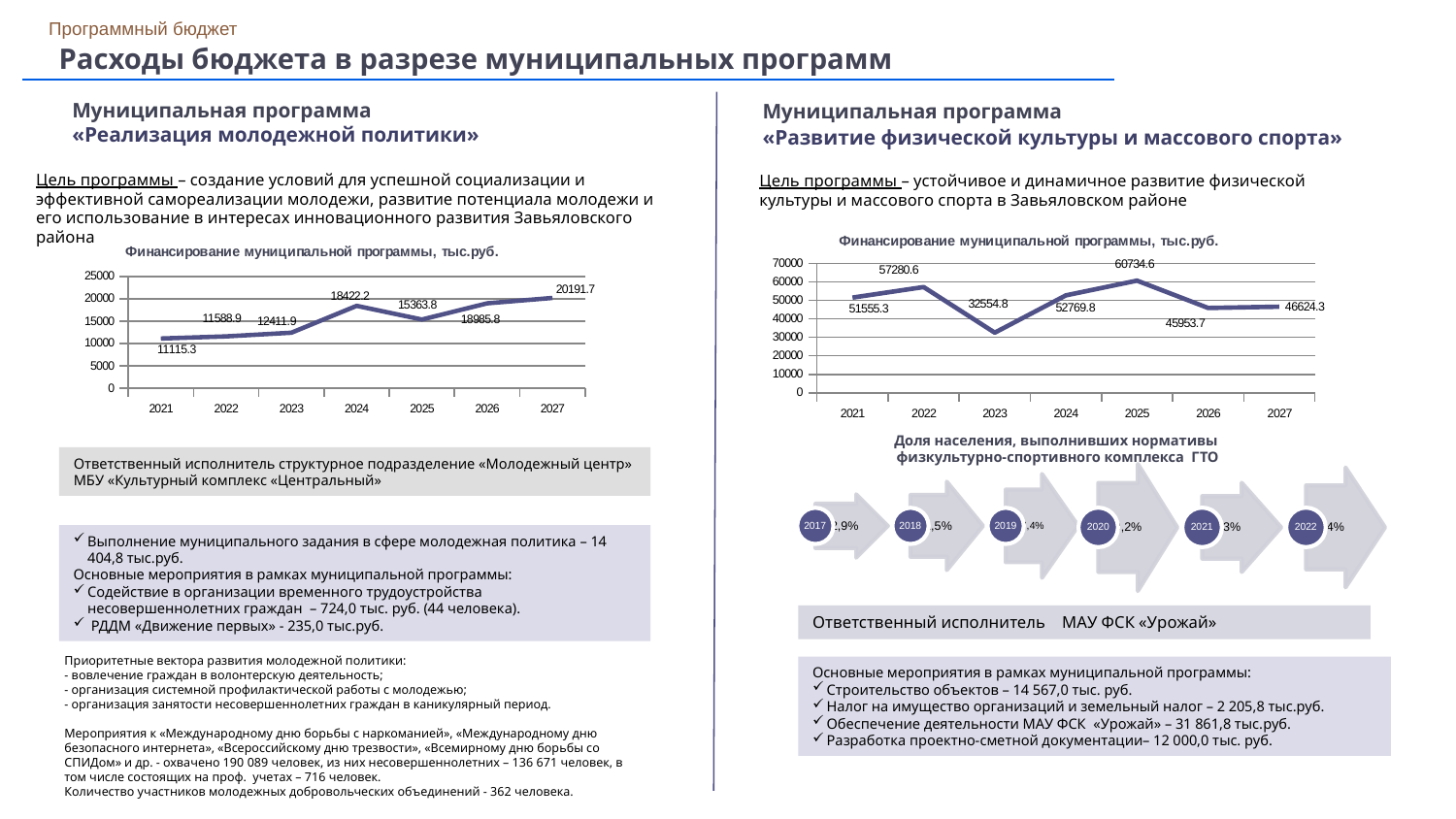
On the right chart (physical culture and sport program funding), which year has the highest value? 2025 On the left chart (youth policy program funding), what is the value for 2021? 11115.3 On the left chart (youth policy program funding), which year has the lowest value? 2021 On the right chart (physical culture and sport program funding), which year has the lowest value? 2023 On the left chart (youth policy program funding), which year has the highest value? 2027 On the left chart (youth policy program funding), what is the value for 2027? 20191.7 On the right chart (physical culture and sport program funding), is the value for 2022 larger or smaller than the value for 2024? larger On the right chart (physical culture and sport program funding), what is the value for 2023? 32554.8 What type of chart is used for the funding of the physical culture and sport program on the right? line chart On the right chart (physical culture and sport program funding), what is the difference between the values for 2027 and 2026? 670.6 On the left chart (youth policy program funding), how many years are plotted on the x axis? 7 On the left chart (youth policy program funding), what is the difference between the values for 2024 and 2025? 3058.4